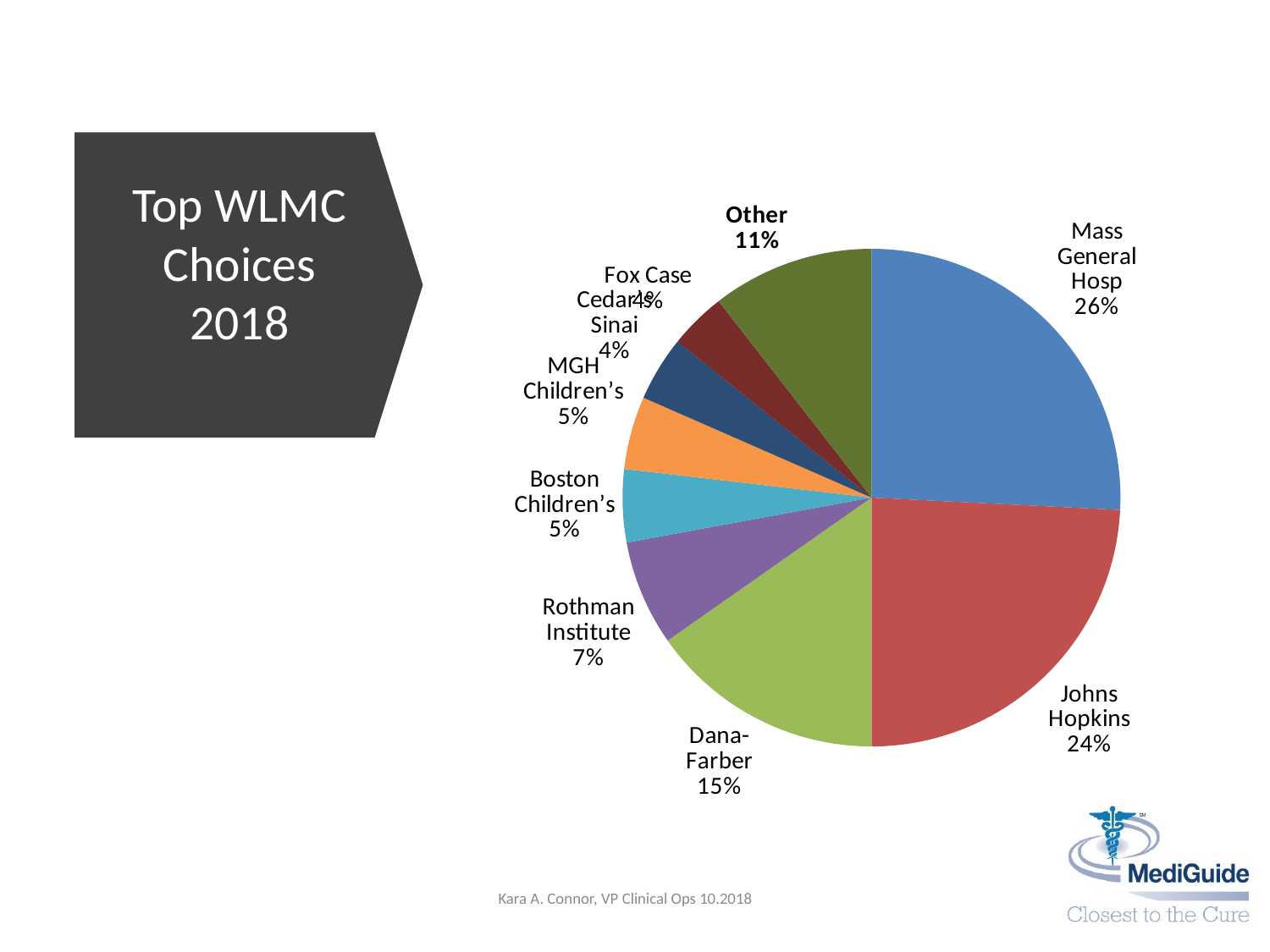
What share of the pie does Cedars Sinai have? 4% Which slice of the pie is the largest? Mass General Hosp What share of the pie does Dana-Farber have? 15% What share of the pie does Other have? 11% What share of the pie does the Rothman Institute have? 7% How many slices does the pie chart have? 9 What share of the pie does Mass General Hosp have? 26% What kind of chart is shown on the slide? pie chart What share of the pie does Johns Hopkins have? 24% Which is larger, the share for Dana-Farber or the share for Other? Dana-Farber What is the difference in percentage points between Mass General Hosp and Johns Hopkins? 2 What is the title shown in the box to the left of the chart? Top WLMC Choices 2018